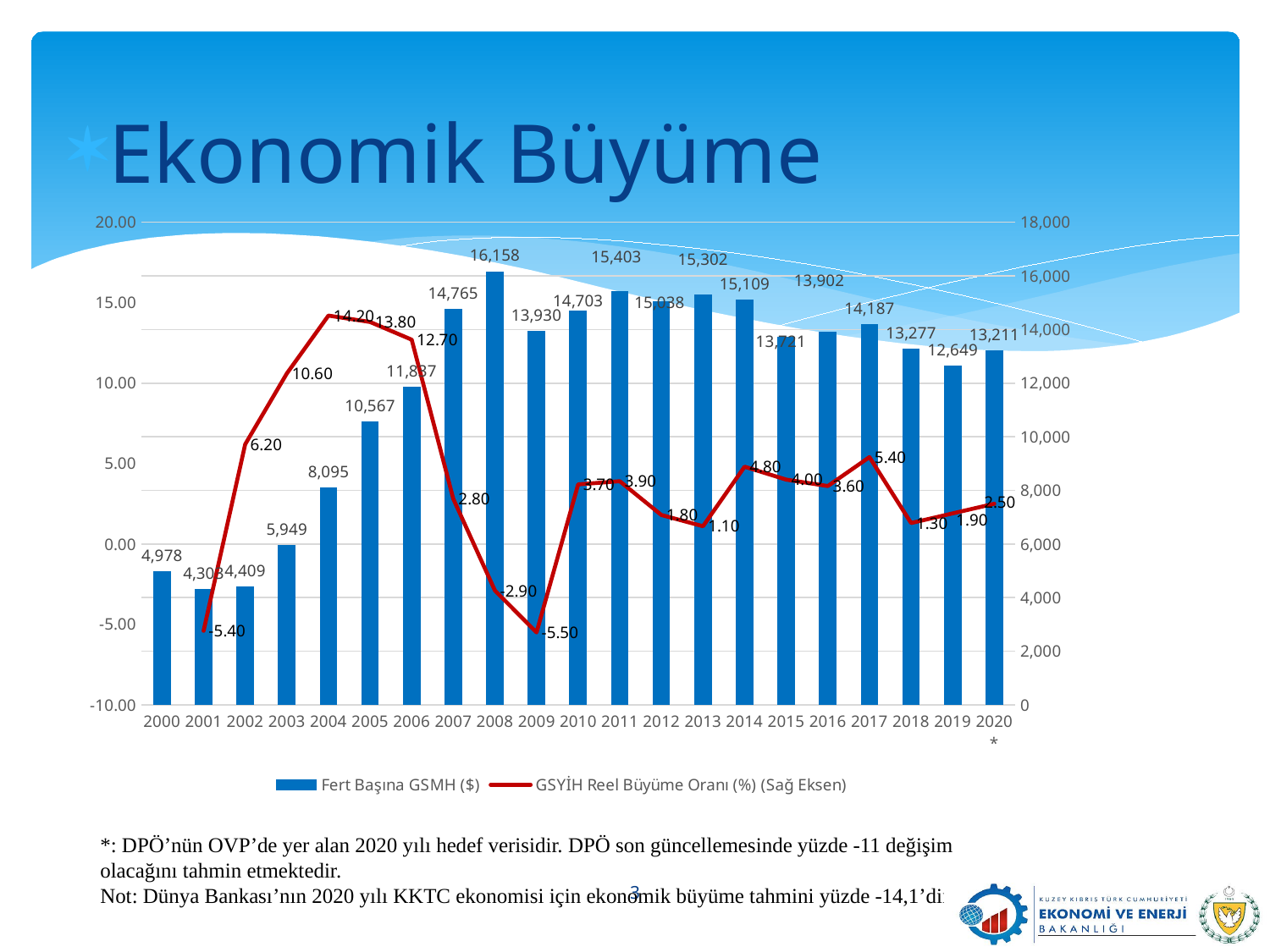
What is the title of the slide containing the chart? Ekonomik Büyüme How many years are shown on the x axis? 21 Which year has the highest GSYİH Reel Büyüme Oranı (%) value? 2004 Which is larger, the Fert Başına GSMH ($) value for 2011 or for 2013? 2011 What is the GSYİH Reel Büyüme Oranı (%) value for 2009? -5.50 Which year has the lowest Fert Başına GSMH ($) value? 2001 What kind of chart is shown on the slide? Combined bar and line chart What is the Fert Başına GSMH ($) value for 2008? 16,158 How many series does the legend list? 2 Does the Fert Başına GSMH ($) value rise or fall from 2000 to 2008? rise What is the difference between the Fert Başına GSMH ($) values for 2008 and 2009? 2,228 Which year has the highest Fert Başına GSMH ($) value? 2008